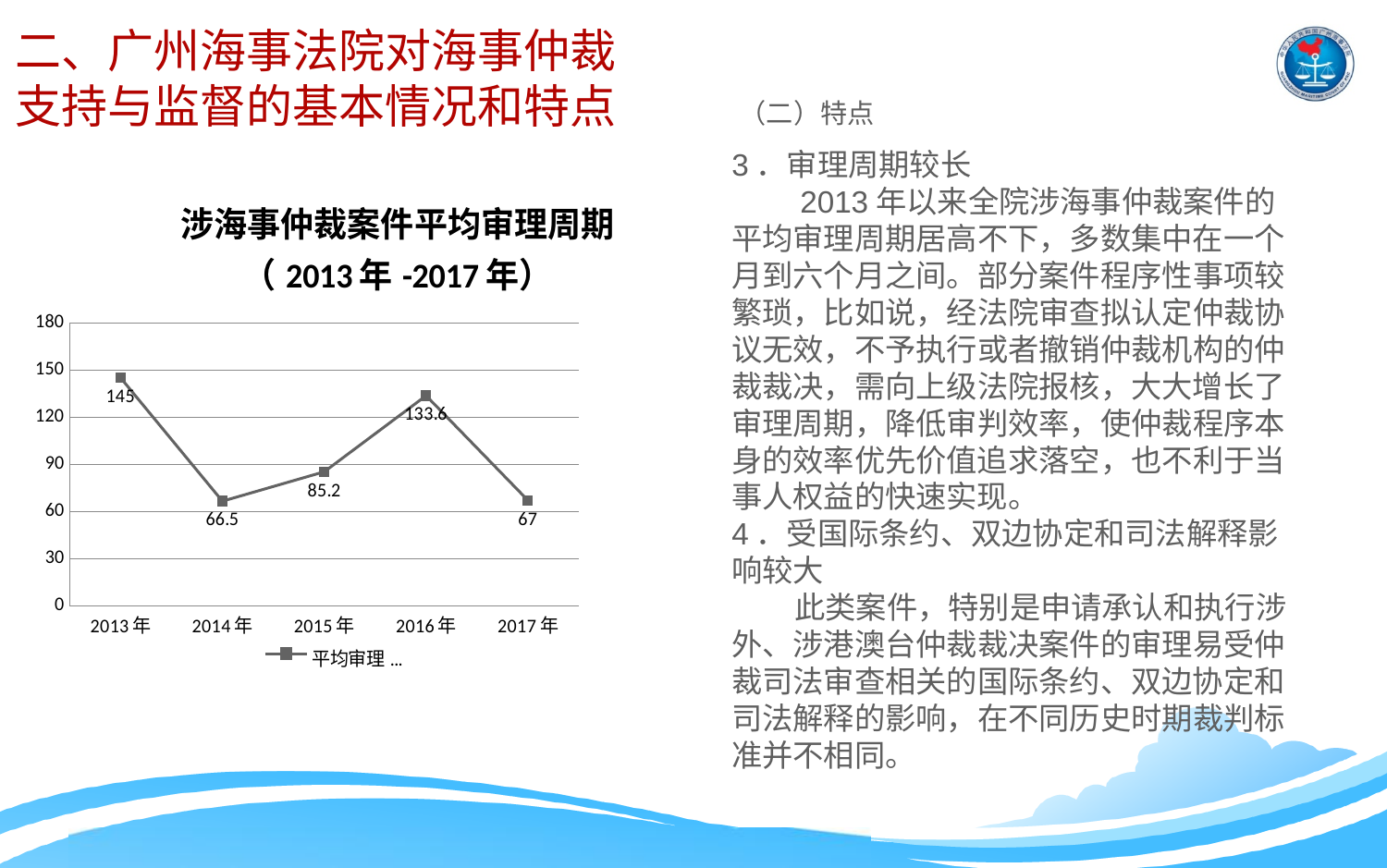
What kind of chart is shown on the slide? line chart Which year has the highest value in the chart? 2013年 Which year has the lowest value in the chart? 2014年 What is the difference between the values for 2016年 and 2015年? 48.4 How many years are plotted on the x axis of the chart? 5 Does the value rise or fall from 2013年 to 2014年? fall Which is larger, the value for 2013年 or the value for 2016年? 2013年 What is the value for 2017年 in the chart? 67 What is the value for 2015年 in the chart? 85.2 What is the value for 2013年 in the chart? 145 What is the title of the chart? 涉海事仲裁案件平均审理周期（2013年-2017年） Is the value for 2014年 greater or less than 90? less